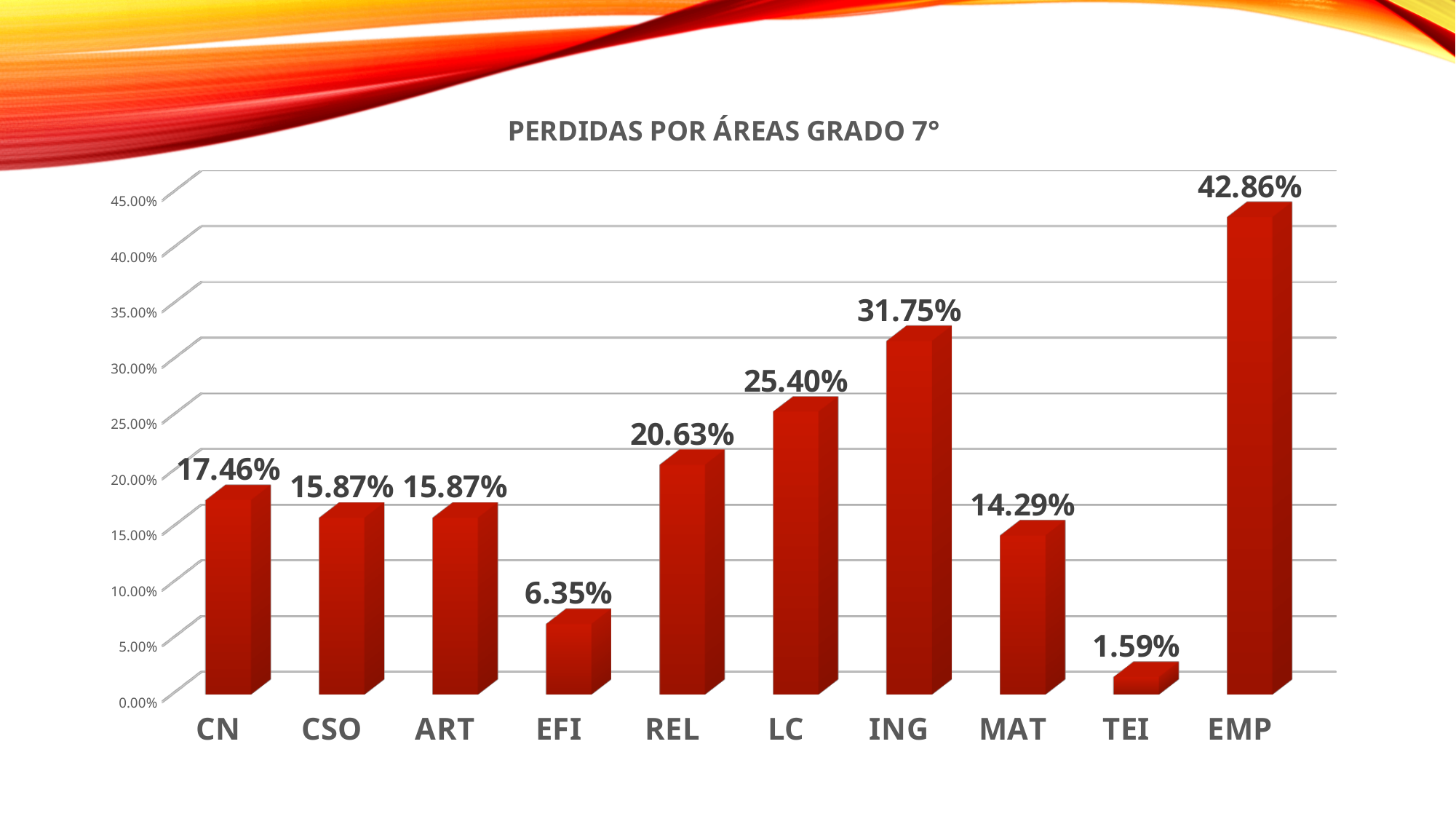
What is the difference between the values for EMP and ING? 11.11% What is the value for ING? 31.75% What kind of chart is shown on the slide? bar chart Is the value for MAT greater or less than 15.00%? less What is the value for REL? 20.63% Which category has the lowest value? TEI Which category has the highest value? EMP Which is larger, the value for LC or the value for REL? LC What is the difference between the values for CN and MAT? 3.17% What is the value for EFI? 6.35% What is the title of the chart? PERDIDAS POR ÁREAS GRADO 7° How many categories are shown on the x axis? 10